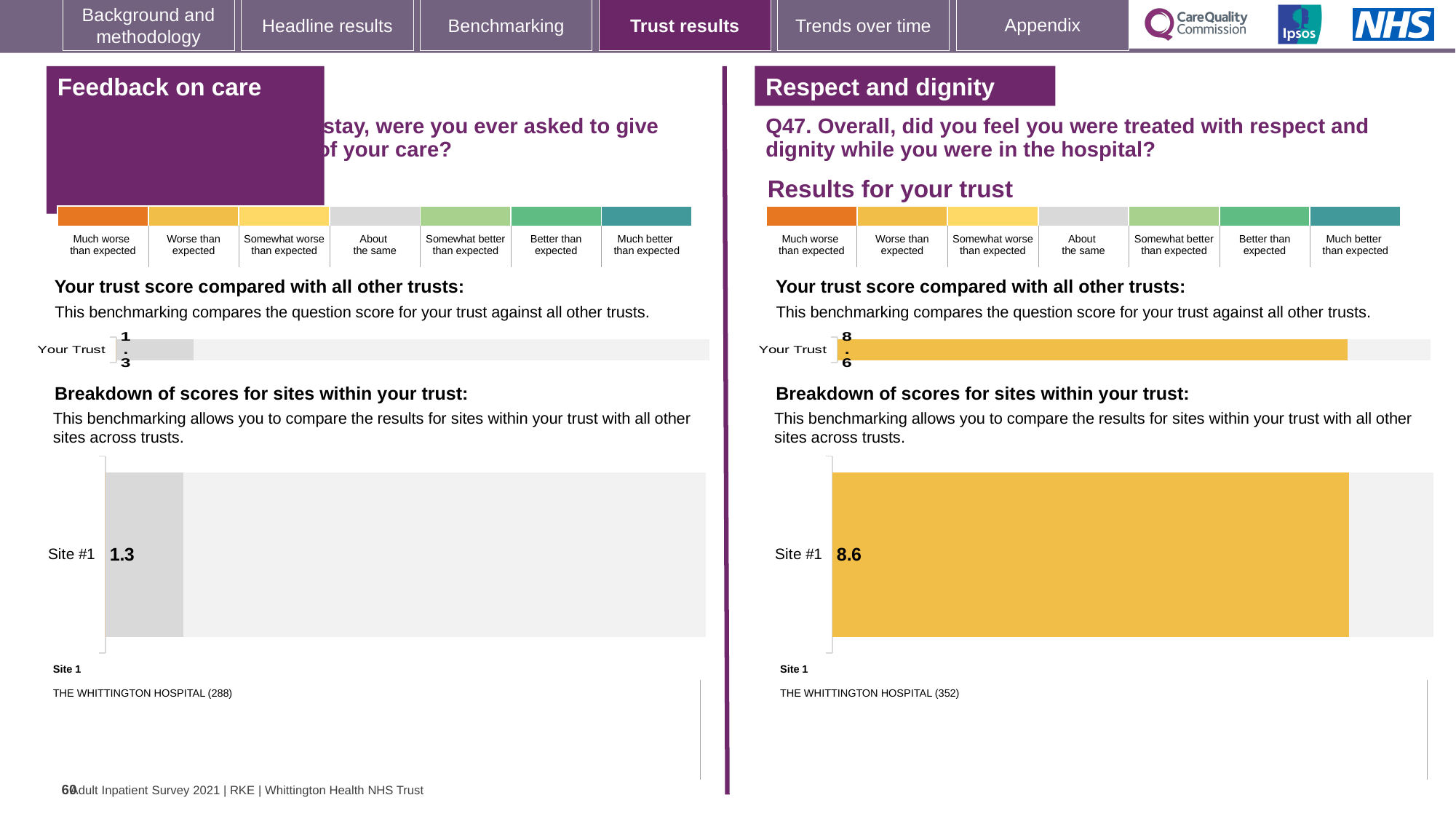
Which Site #1 score is larger: the one in the 'Feedback on care' section or the one in the 'Respect and dignity' section? Respect and dignity In the 'Respect and dignity' section, what is the score shown for Site #1? 8.6 How many sites are shown in the site breakdown chart in the 'Respect and dignity' section? 1 In the 'Feedback on care' section, what score is shown for 'Your Trust' in the trust comparison chart? 1.3 What kind of chart is used to show the Site #1 score in the 'Respect and dignity' section? Bar chart What is the difference between the Site #1 score in the 'Respect and dignity' section and the Site #1 score in the 'Feedback on care' section? 7.3 Which hospital is listed as Site 1 in the 'Respect and dignity' section? THE WHITTINGTON HOSPITAL (352) In the 'Feedback on care' section, what is the score shown for Site #1? 1.3 What colour is the Site #1 bar in the 'Respect and dignity' section? Yellow In the 'Respect and dignity' section, what score is shown for 'Your Trust' in the trust comparison chart? 8.6 How many sites are shown in the site breakdown chart in the 'Feedback on care' section? 1